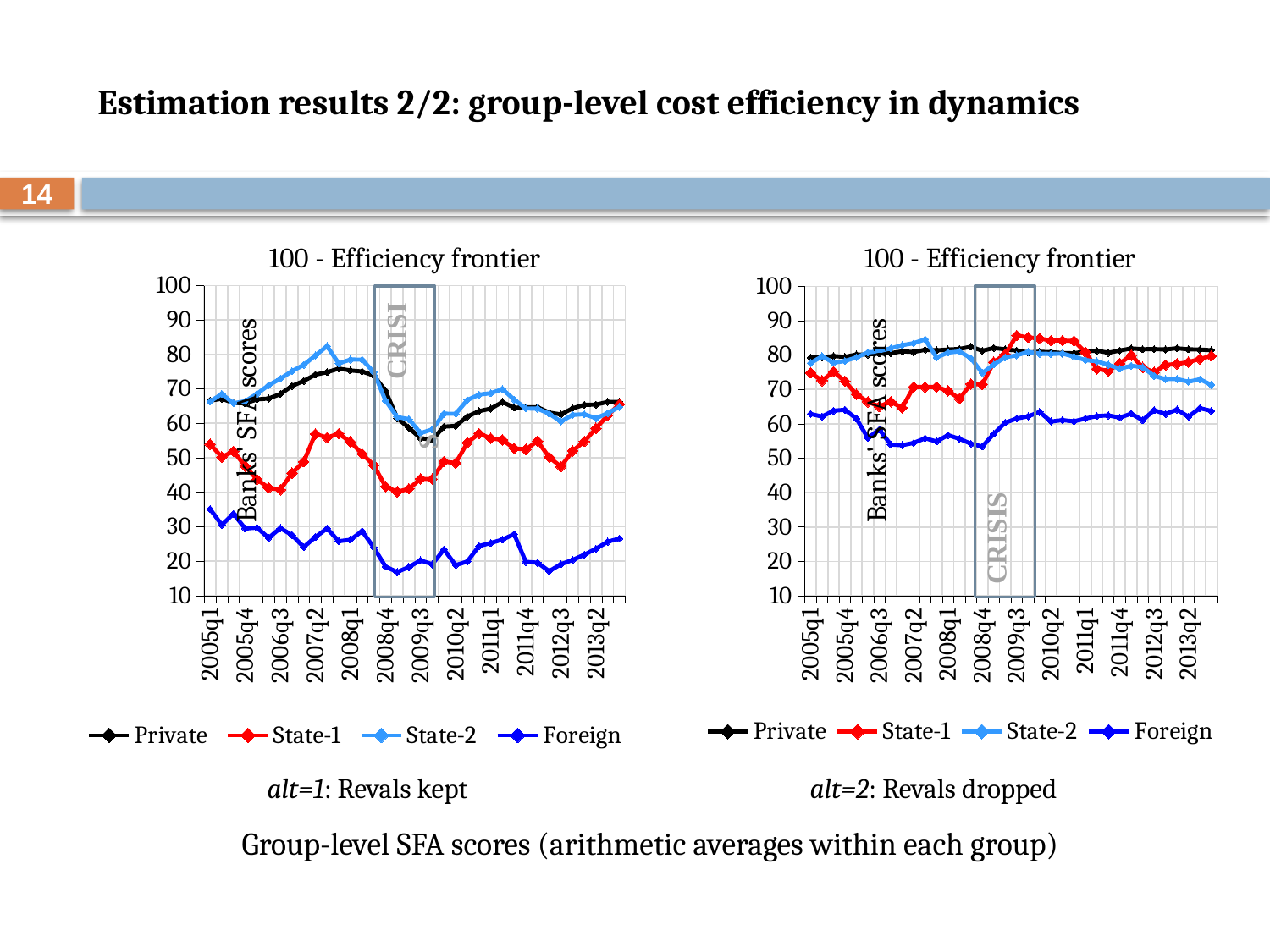
In the left chart (alt=1: Revals kept), is the value for Foreign at 2005q1 greater or less than 40? less In the right chart (alt=2: Revals dropped), which series has the lowest values across the whole period? Foreign In the right chart (alt=2: Revals dropped), is the value for State-2 at 2013q2 greater or less than 80? less What is the title of the left chart? 100 - Efficiency frontier What type of chart is the left chart (alt=1: Revals kept)? line chart In the right chart (alt=2: Revals dropped), which is larger at 2013q2: Private or State-2? Private In the left chart (alt=1: Revals kept), which series has the lowest values across the whole period? Foreign In the right chart (alt=2: Revals dropped), is the value for Foreign at 2008q4 greater or less than 60? less In the left chart (alt=1: Revals kept), does the Foreign series rise or fall from 2005q1 to 2008q4? fall How many series does the legend of the right chart (alt=2: Revals dropped) list? 4